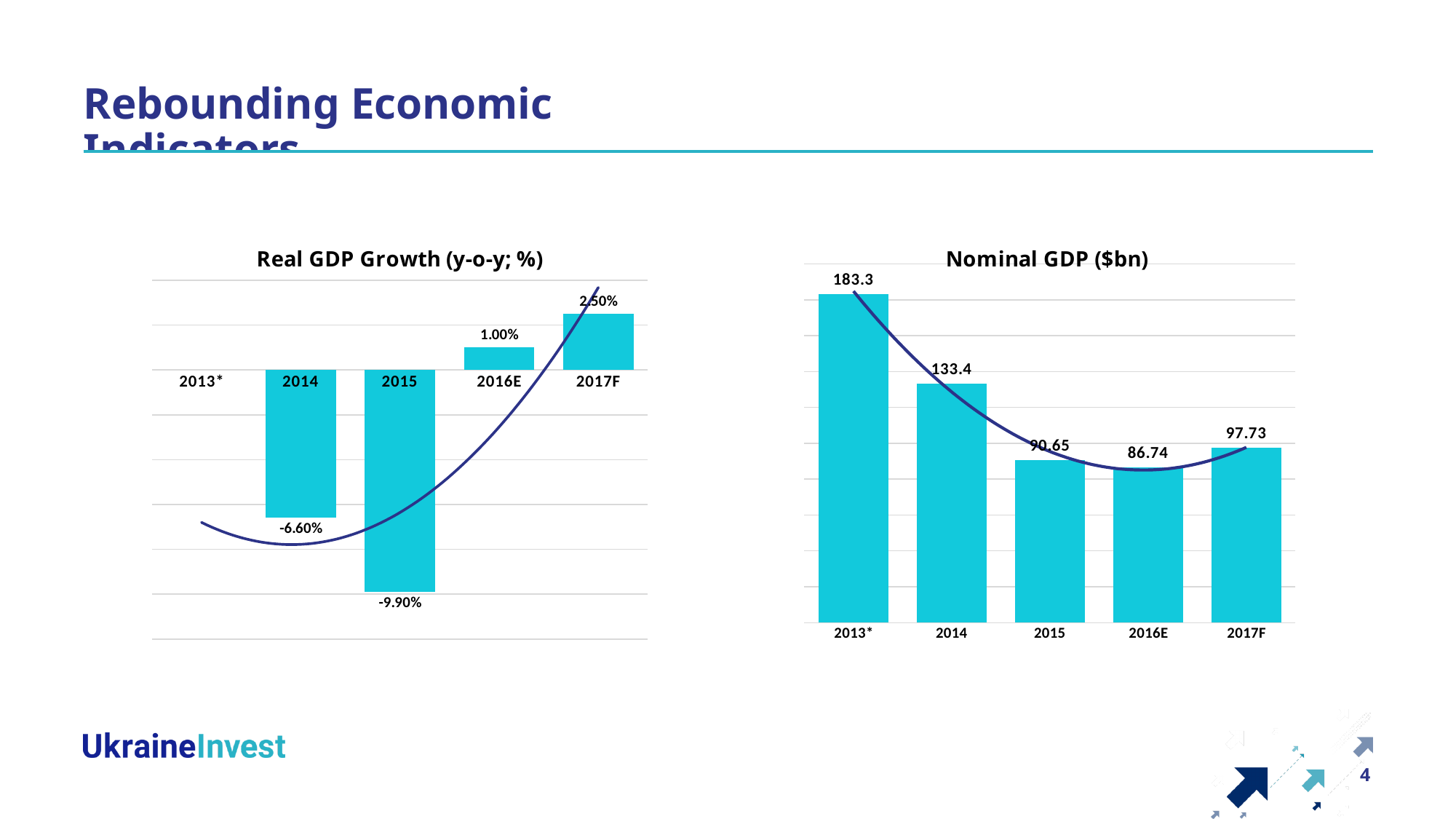
In the Real GDP Growth (y-o-y; %) chart, which year has the lowest value? 2015 In the Nominal GDP ($bn) chart, which year has the highest value? 2013* How many bars are plotted in the Nominal GDP ($bn) chart? 5 In the Real GDP Growth (y-o-y; %) chart, what is the value for 2017F? 2.50% In the Real GDP Growth (y-o-y; %) chart, which is larger, the value for 2014 or the value for 2016E? 2016E In the Real GDP Growth (y-o-y; %) chart, what is the difference between the 2017F and 2016E values? 1.50% In the Nominal GDP ($bn) chart, what is the difference between the 2013* and 2014 values? 49.9 What type of chart is the Nominal GDP ($bn) chart? Bar chart In the Real GDP Growth (y-o-y; %) chart, what is the value for 2015? -9.90% In the Nominal GDP ($bn) chart, what is the value for 2013*? 183.3 In the Nominal GDP ($bn) chart, which year has the lowest value? 2016E In the Nominal GDP ($bn) chart, what is the value for 2016E? 86.74